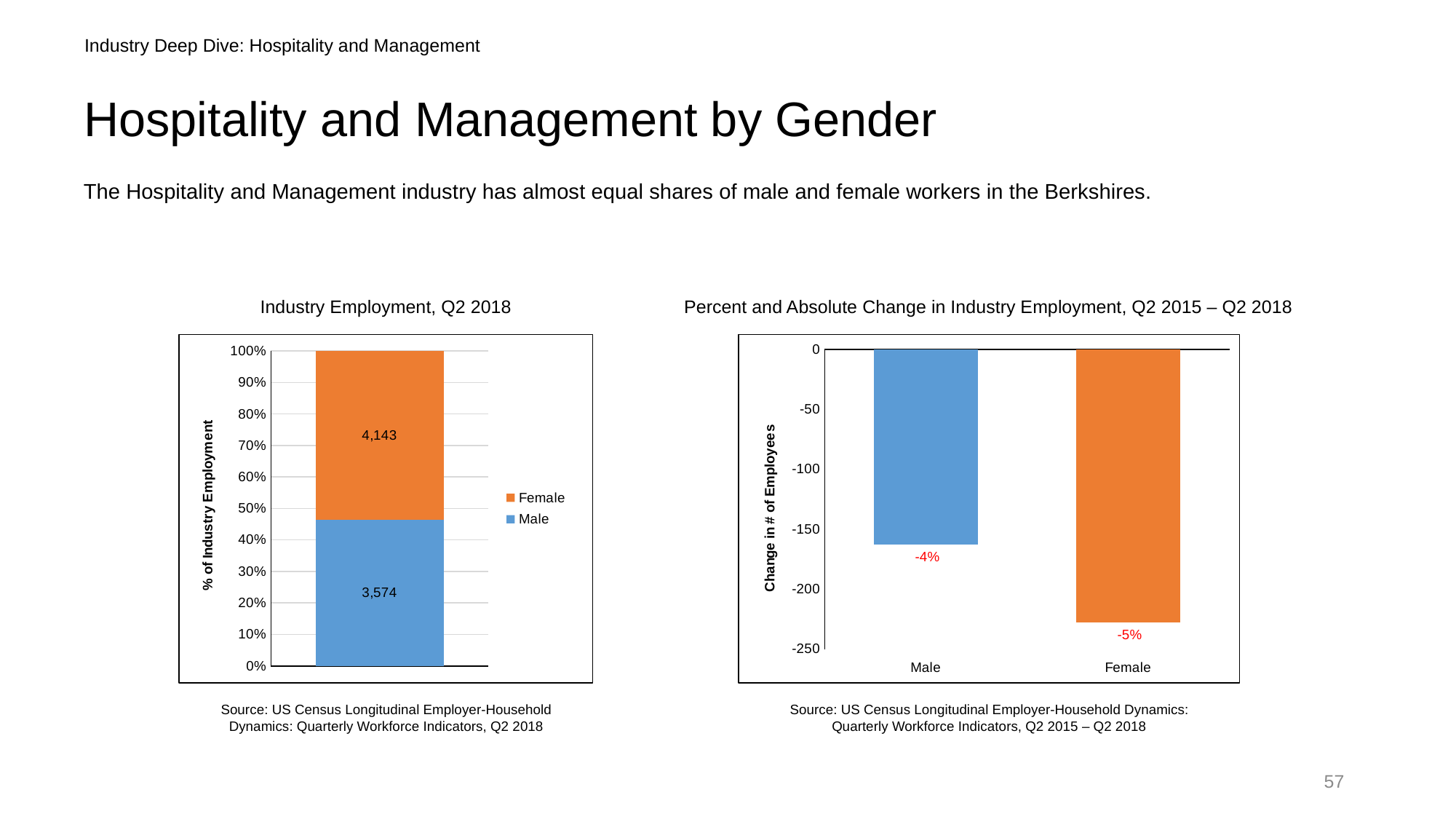
In the 'Percent and Absolute Change in Industry Employment, Q2 2015 – Q2 2018' chart, what is the percent change for Male? -4% In the 'Industry Employment, Q2 2018' chart, what is the difference between the female and male employee counts? 569 In the 'Percent and Absolute Change in Industry Employment, Q2 2015 – Q2 2018' chart, what is the percent change for Female? -5% In the 'Industry Employment, Q2 2018' chart, how many male employees are shown? 3,574 In the 'Industry Employment, Q2 2018' chart, how many female employees are shown? 4,143 What kind of chart is the 'Industry Employment, Q2 2018' chart? Stacked bar chart In the 'Industry Employment, Q2 2018' chart, which group has more employees, Female or Male? Female In the 'Percent and Absolute Change in Industry Employment, Q2 2015 – Q2 2018' chart, is the change in number of employees for Female greater or less than -200? less In the 'Percent and Absolute Change in Industry Employment, Q2 2015 – Q2 2018' chart, what is the y-axis title? Change in # of Employees In the 'Industry Employment, Q2 2018' chart, what is the total number of employees across both groups? 7,717 In the 'Percent and Absolute Change in Industry Employment, Q2 2015 – Q2 2018' chart, is the change in number of employees for Male greater or less than -200? greater In the 'Industry Employment, Q2 2018' chart, how many series does the legend list? 2